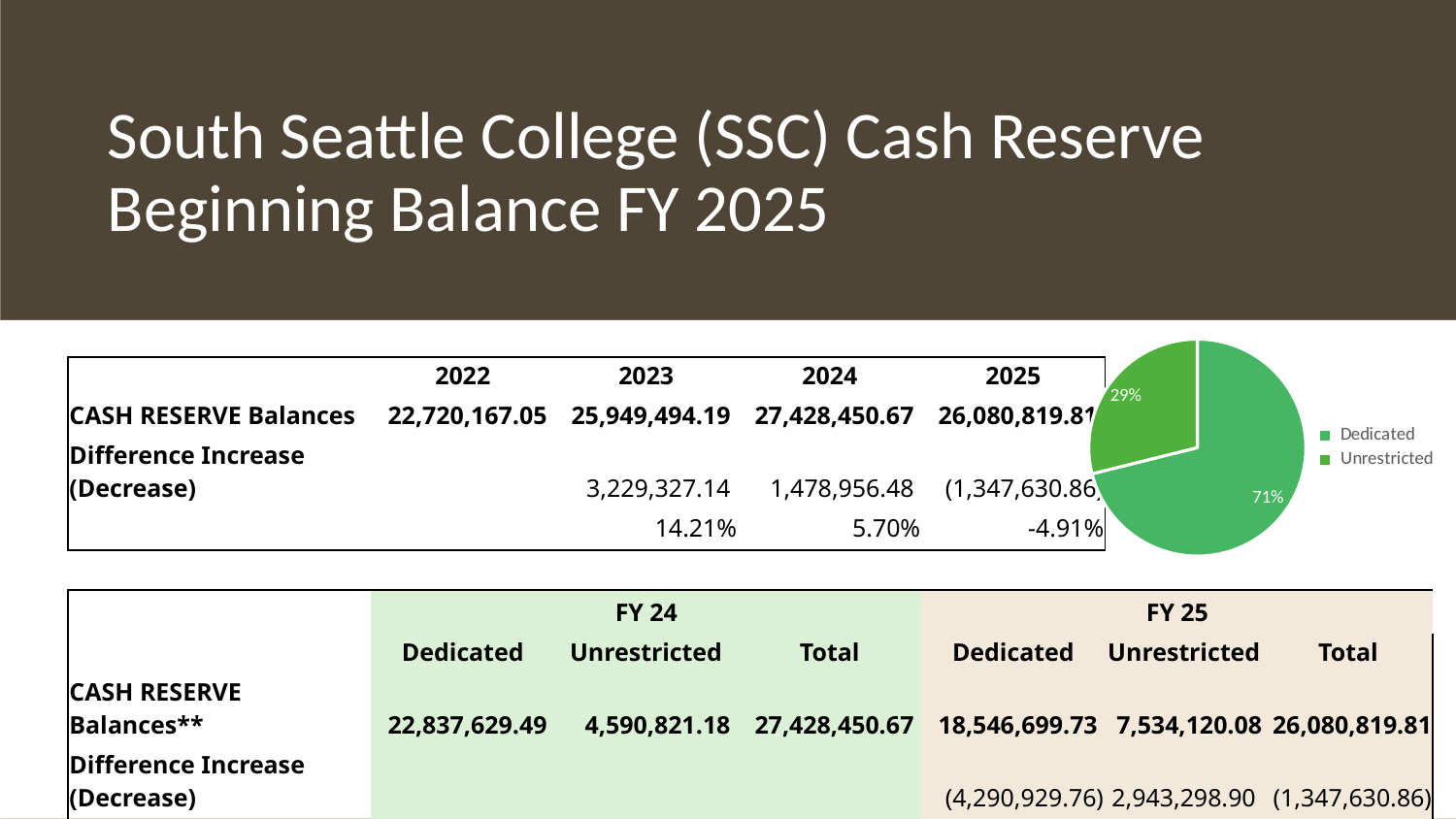
How many entries does the pie chart's legend list? 2 How many slices does the pie chart have? 2 In the pie chart, what share does the Dedicated slice represent? 71% Is the Unrestricted slice of the pie chart greater or less than 50%? less What is the difference in percentage points between the Dedicated and Unrestricted slices of the pie chart? 42 Which slice of the pie chart is the smallest? Unrestricted What kind of chart is shown on the slide? pie chart What are the two legend entries of the pie chart? Dedicated and Unrestricted Is the Dedicated slice of the pie chart greater or less than 50%? greater Which slice of the pie chart is the largest? Dedicated In the pie chart, what share does the Unrestricted slice represent? 29% In the pie chart, which is larger, the Dedicated slice or the Unrestricted slice? Dedicated